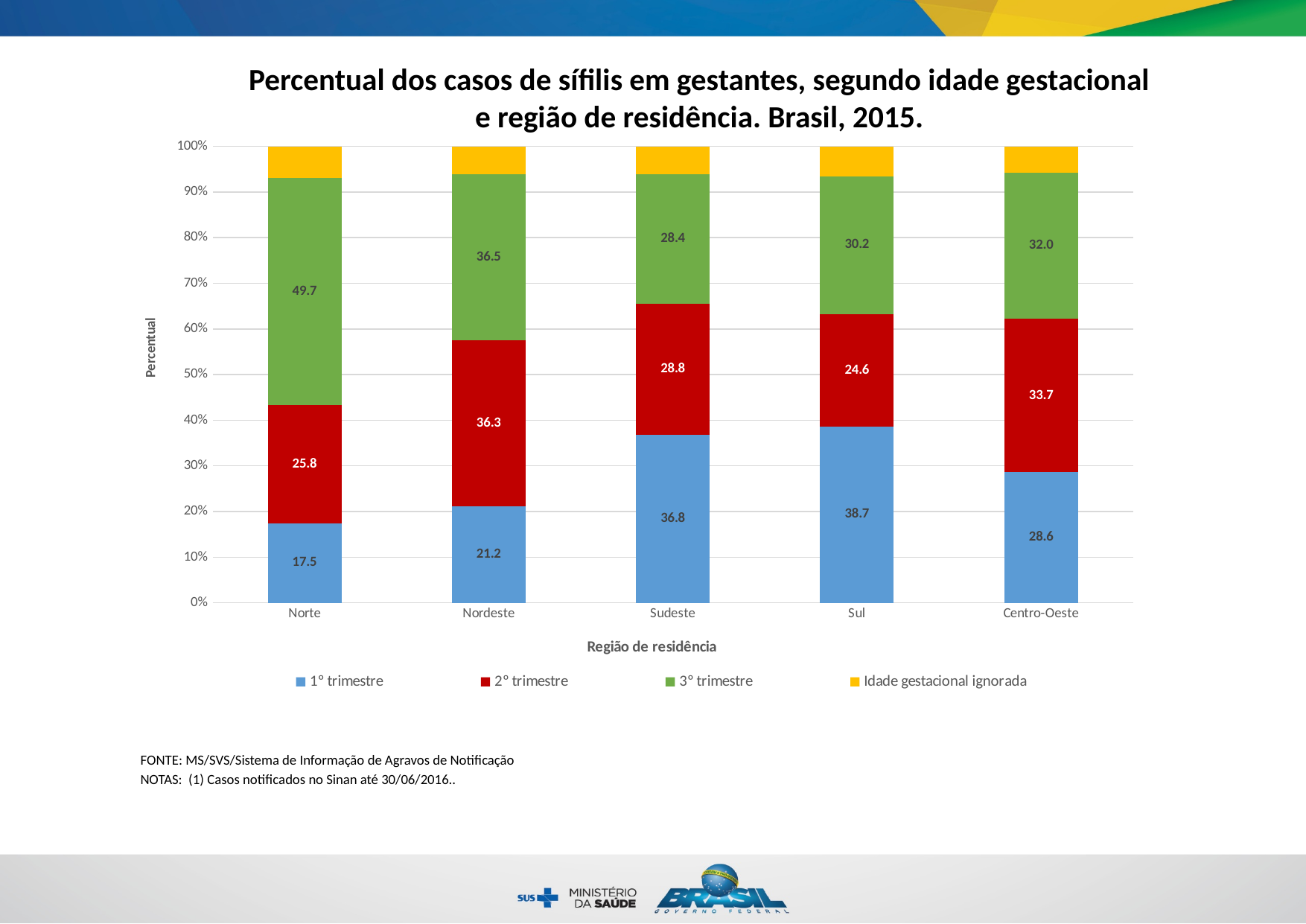
How many series does the legend list? 4 What is the value for 2° trimestre in the Centro-Oeste region? 33.7 What kind of chart is shown on the slide? Stacked bar chart Which region has the highest value for 1° trimestre? Sul What is the difference between the 1° trimestre values for Sul and Norte? 21.2 What is the value for 3° trimestre in the Nordeste region? 36.5 Which is larger, the 2° trimestre value for Nordeste or for Sudeste? Nordeste Which series is shown in yellow in the legend? Idade gestacional ignorada What is the value for 1° trimestre in the Norte region? 17.5 How many regions are shown on the x axis? 5 What is the label of the x axis? Região de residência Which region has the lowest value for 3° trimestre? Sudeste